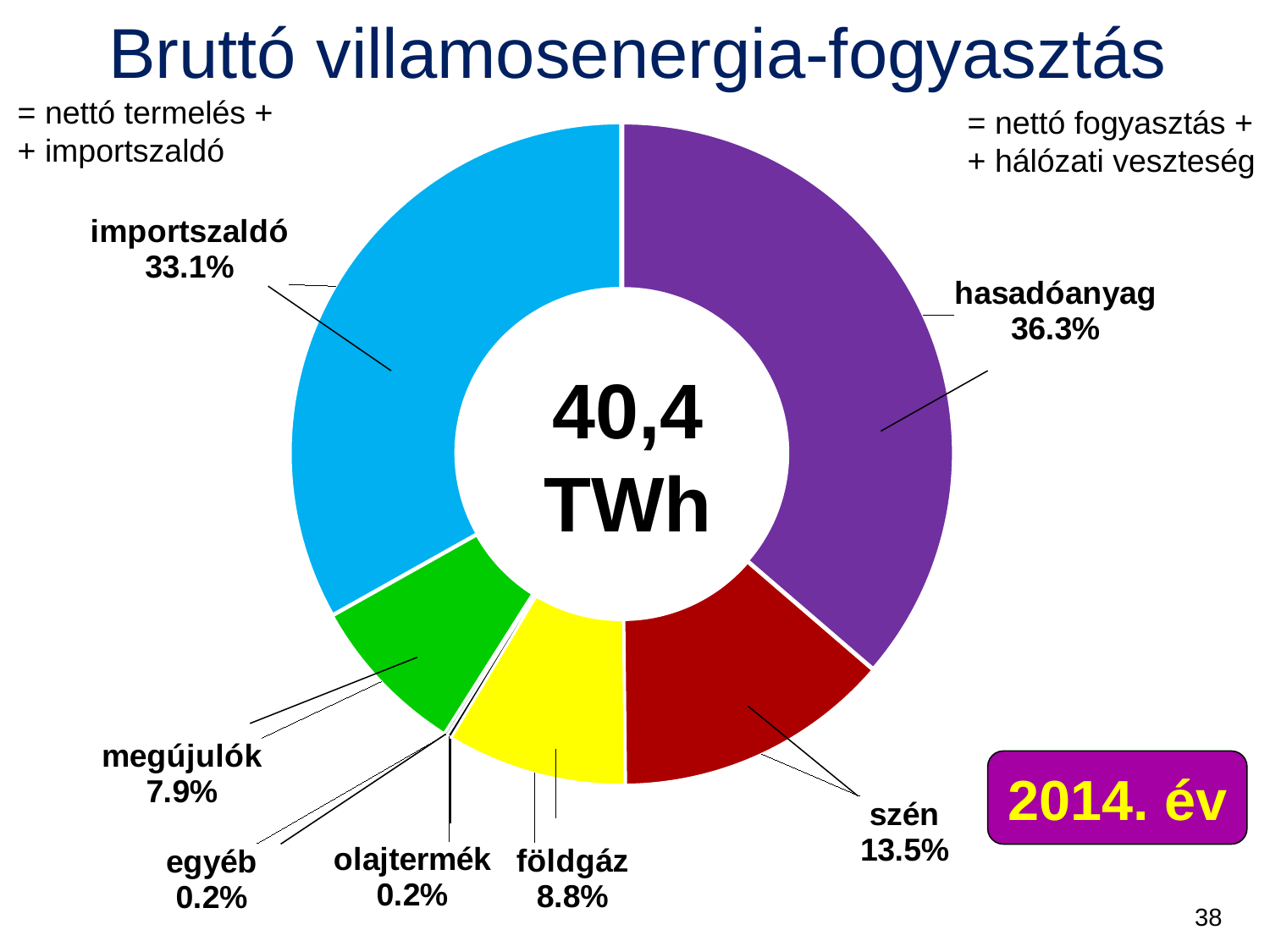
What kind of chart is shown on the slide? pie (doughnut) chart What is the value shown for importszaldó? 33.1% What is the difference in percentage points between hasadóanyag and importszaldó? 3.2 percentage points What share is shown for megújulók? 7.9% Which category has the largest share of the chart? hasadóanyag What percentage is shown for szén? 13.5% What is the value for földgáz? 8.8% Which is larger, the share for szén or the share for földgáz? szén What is the difference in percentage points between szén and földgáz? 4.7 percentage points What share of the chart does hasadóanyag account for? 36.3% How many categories are shown in the chart? 7 What total value is printed in the centre of the chart? 40,4 TWh